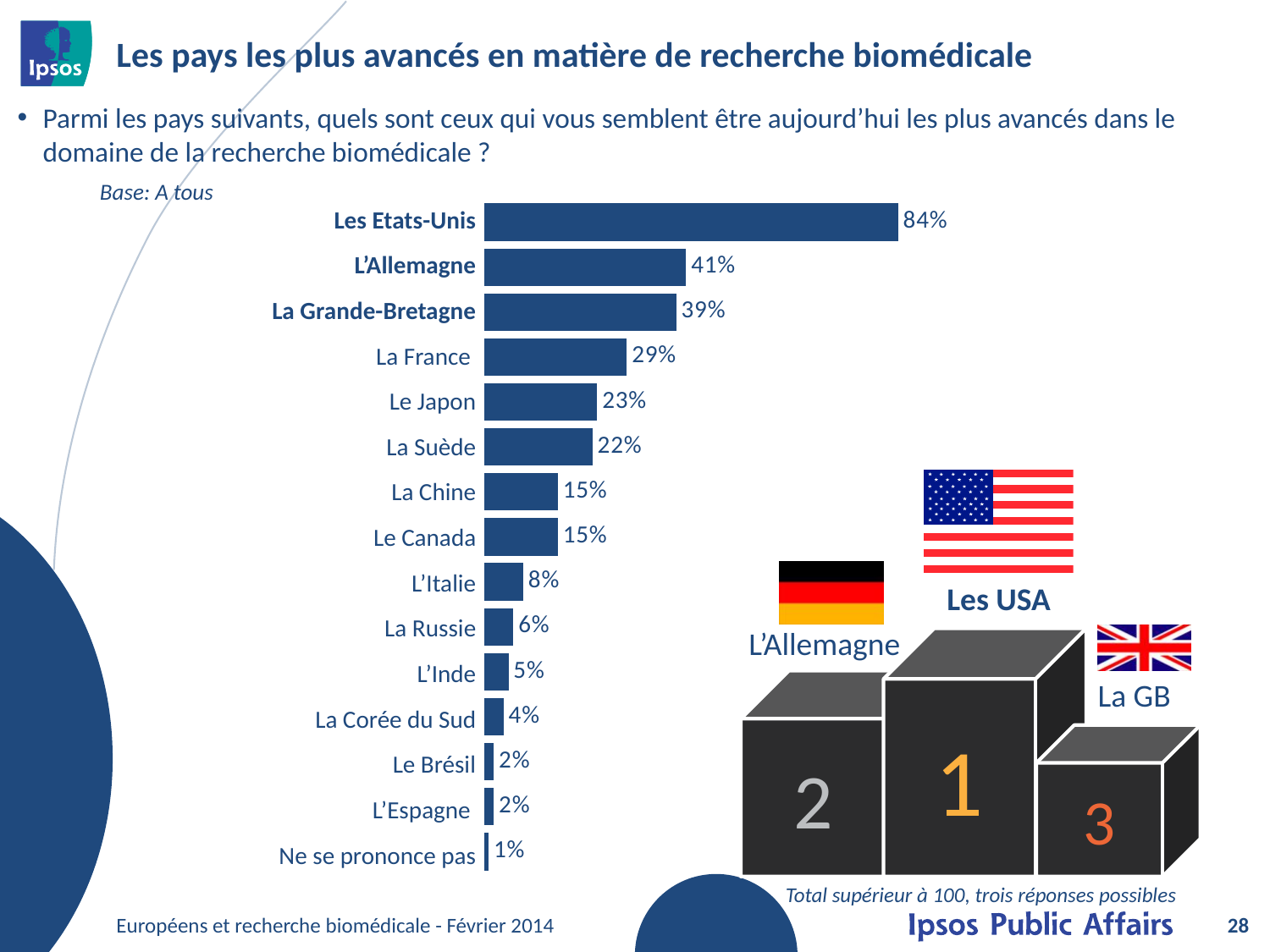
Which is larger, the value for L'Allemagne or La Grande-Bretagne? L'Allemagne How many categories are shown in the bar chart? 15 What is the difference between the values for La France and Le Japon? 6% What is the value for La France? 29% What kind of chart is shown on the slide? bar chart Which country has the highest value? Les Etats-Unis What is the value for La Suède? 22% Which country is shown on the first place of the podium? Les USA What is the value for Les Etats-Unis? 84% Which category has the lowest value? Ne se prononce pas What is the value for La Corée du Sud? 4% What is the difference between the values for Les Etats-Unis and L'Allemagne? 43%